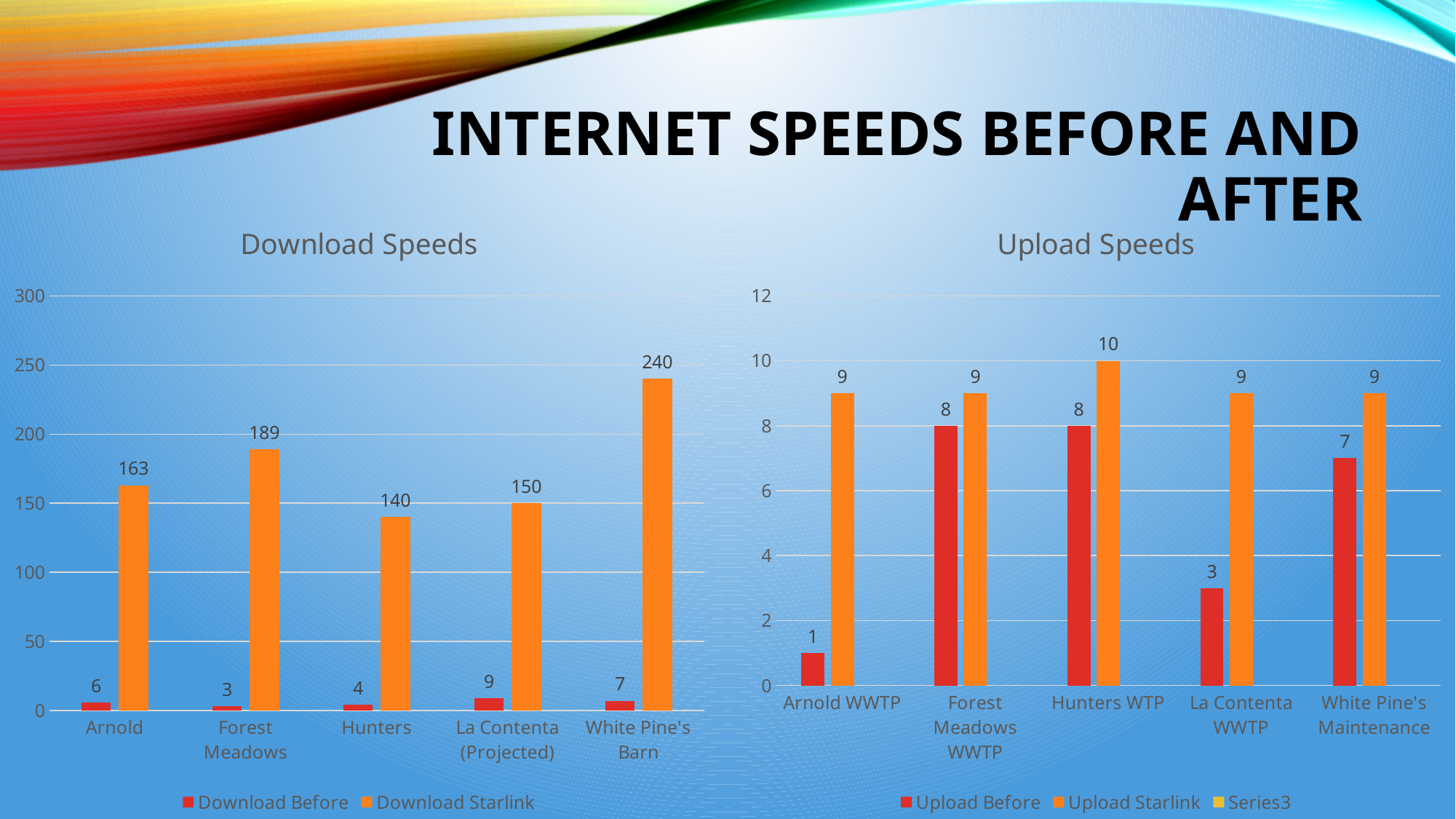
In the Download Speeds chart, what is the difference between the Download Starlink and Download Before values for Forest Meadows? 186 In the Upload Speeds chart, which category has the lowest Upload Before value? Arnold WWTP In the Download Speeds chart, what is the Download Starlink value for White Pine's Barn? 240 In the Download Speeds chart, which is larger: the Download Starlink value for Arnold or for La Contenta (Projected)? Arnold In the Download Speeds chart, which category has the lowest Download Starlink value? Hunters What type of chart is the Upload Speeds chart? Bar chart In the Upload Speeds chart, what is the difference between the Upload Starlink and Upload Before values for La Contenta WWTP? 6 In the Upload Speeds chart, what is the Upload Starlink value for Hunters WTP? 10 How many categories are shown in the Download Speeds chart? 5 In the Download Speeds chart, what is the Download Before value for La Contenta (Projected)? 9 How many series does the legend of the Upload Speeds chart list? 3 What is the title of the chart on the left side of the slide? Download Speeds